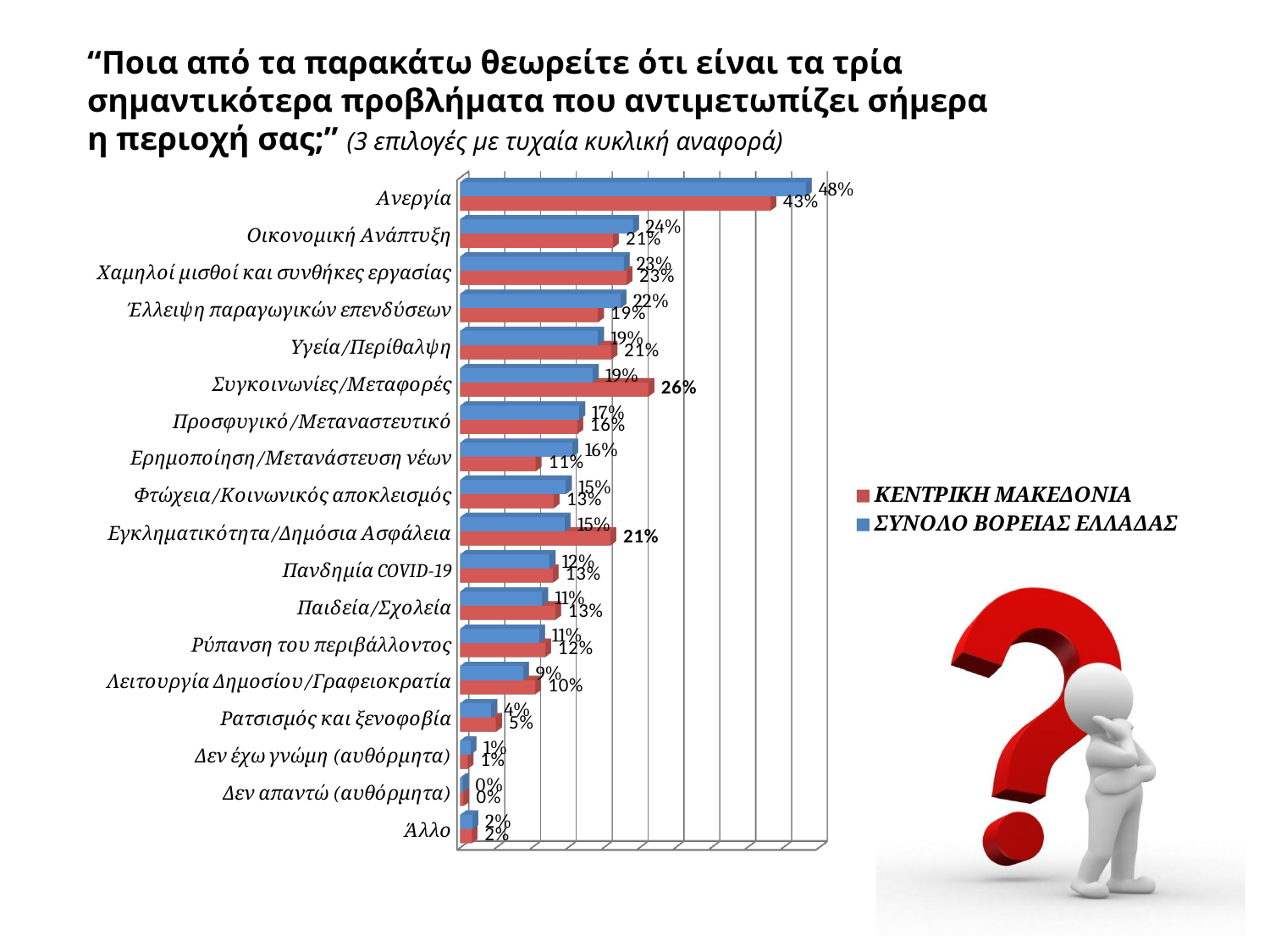
How many categories are plotted on the chart? 18 Which colour represents the ΚΕΝΤΡΙΚΗ ΜΑΚΕΔΟΝΙΑ series? Red What is the value for Ανεργία in the ΣΥΝΟΛΟ ΒΟΡΕΙΑΣ ΕΛΛΑΔΑΣ series? 48% How many series does the legend list? 2 Which category has the highest value in the ΚΕΝΤΡΙΚΗ ΜΑΚΕΔΟΝΙΑ series? Ανεργία What is the difference between the ΣΥΝΟΛΟ ΒΟΡΕΙΑΣ ΕΛΛΑΔΑΣ and ΚΕΝΤΡΙΚΗ ΜΑΚΕΔΟΝΙΑ values for Ανεργία? 5% Which category has the lowest value in the ΣΥΝΟΛΟ ΒΟΡΕΙΑΣ ΕΛΛΑΔΑΣ series? Δεν απαντώ (αυθόρμητα) What is the value for Εγκληματικότητα/Δημόσια Ασφάλεια in the ΚΕΝΤΡΙΚΗ ΜΑΚΕΔΟΝΙΑ series? 21% What is the difference between the ΚΕΝΤΡΙΚΗ ΜΑΚΕΔΟΝΙΑ and ΣΥΝΟΛΟ ΒΟΡΕΙΑΣ ΕΛΛΑΔΑΣ values for Ερημοποίηση/Μετανάστευση νέων? 5% What type of chart is shown on the slide? Bar chart What is the value for Συγκοινωνίες/Μεταφορές in the ΚΕΝΤΡΙΚΗ ΜΑΚΕΔΟΝΙΑ series? 26% For Συγκοινωνίες/Μεταφορές, which series has the larger value: ΚΕΝΤΡΙΚΗ ΜΑΚΕΔΟΝΙΑ or ΣΥΝΟΛΟ ΒΟΡΕΙΑΣ ΕΛΛΑΔΑΣ? ΚΕΝΤΡΙΚΗ ΜΑΚΕΔΟΝΙΑ